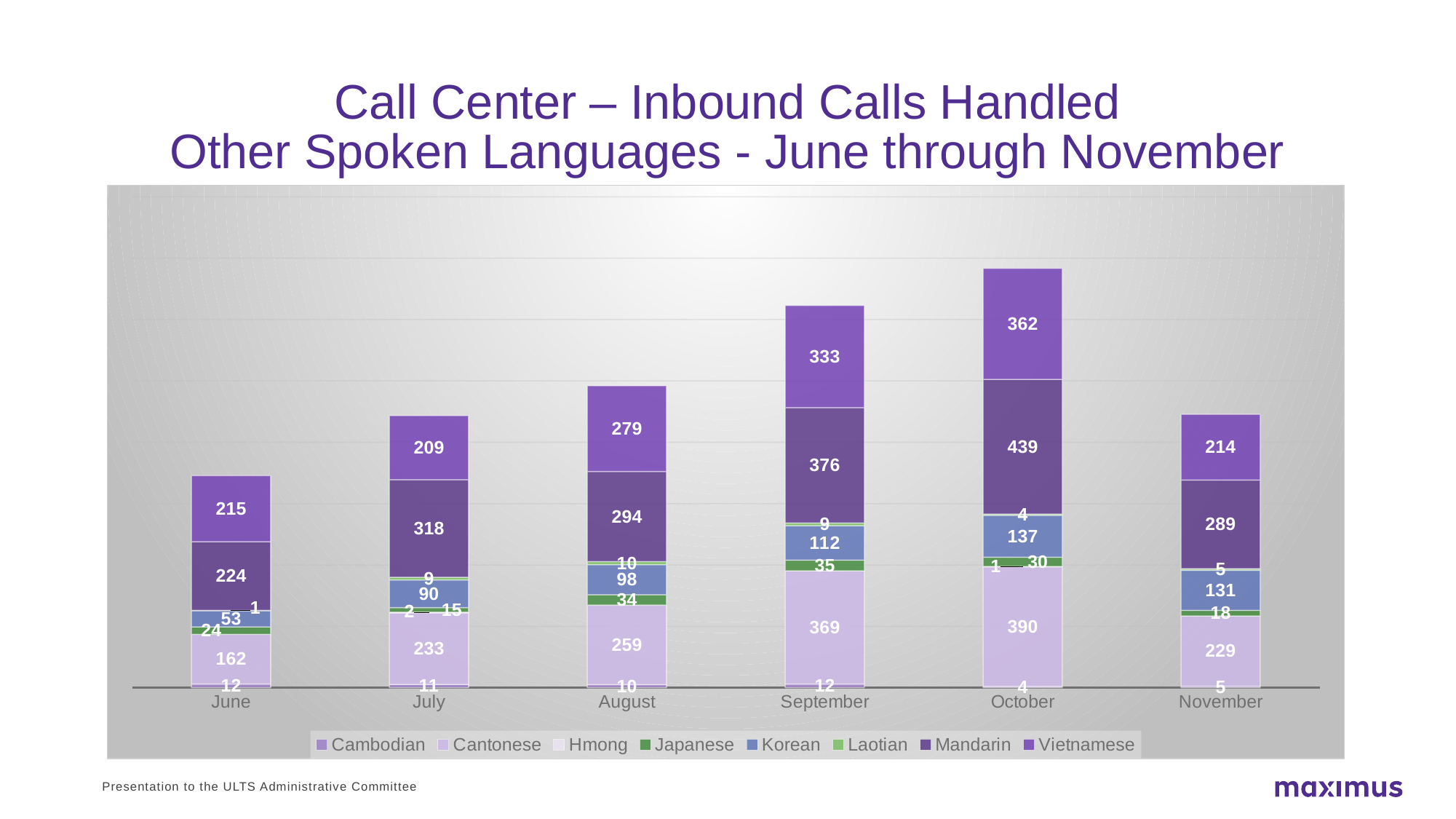
What kind of chart is shown on the slide? Stacked bar chart How many months are shown on the x axis? 6 What is the value for Korean in November? 131 What is the difference between the Mandarin values for October and June? 215 What is the value for Mandarin in October? 439 What is the value for Cantonese in September? 369 Which is larger, the Korean value in August or the Korean value in September? September In which month is the Vietnamese value highest? October What is the value for Vietnamese in June? 215 How many series does the legend list? 8 Which language is listed first in the legend? Cambodian In which month is the Cantonese value lowest? June